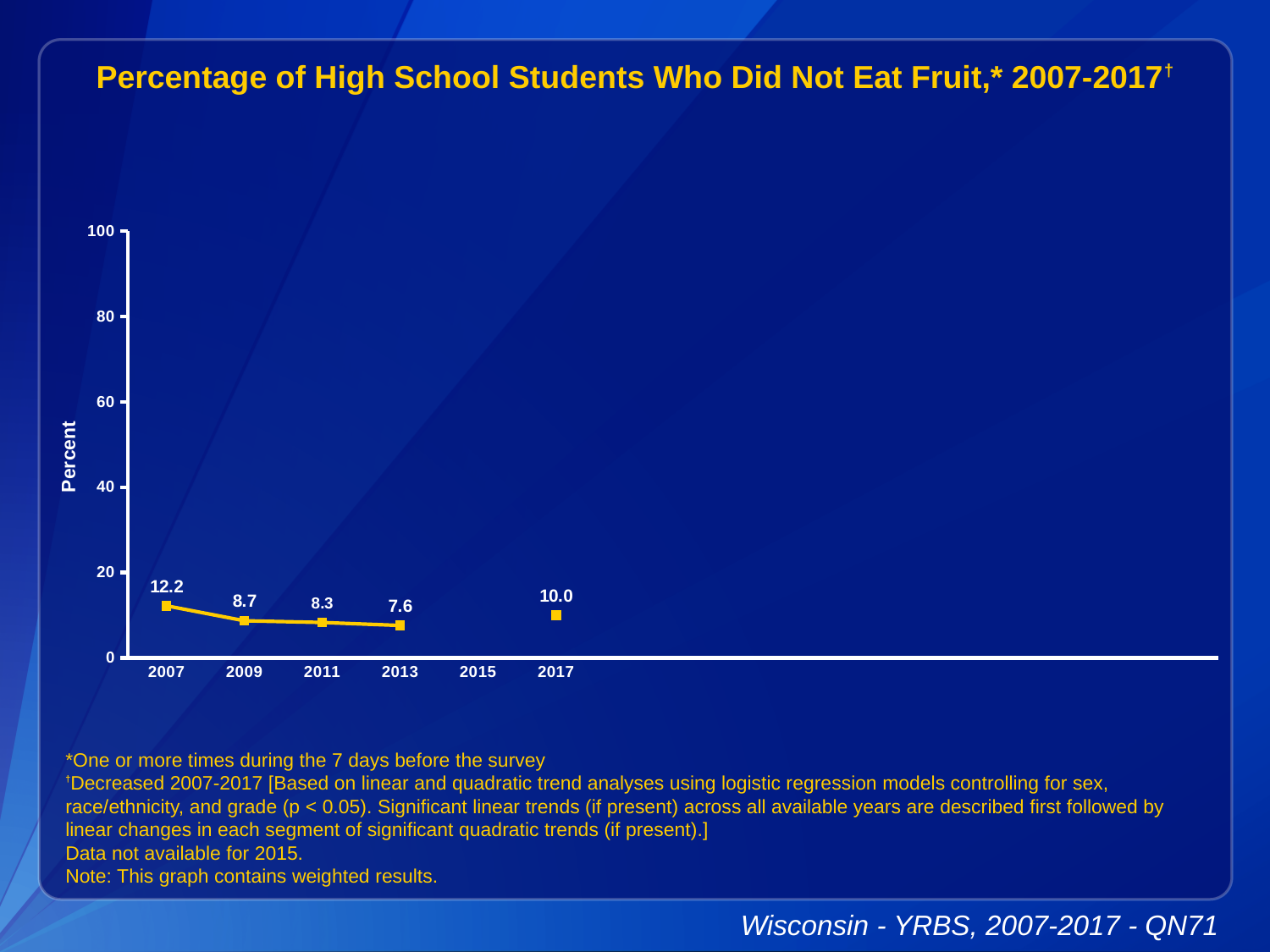
Which year has the highest value? 2007 Which year has the lowest value? 2013 What kind of chart is this? line chart Which is larger, the value for 2009 or the value for 2017? 2017 What is the value for 2007? 12.2 What is the value for 2017? 10.0 What is the difference between the values for 2007 and 2013? 4.6 What is the value for 2013? 7.6 Is the value for 2007 greater or less than 20? less How many years have a plotted data point? 5 What is the label on the y axis? Percent Do the values rise or fall from 2007 to 2013? fall